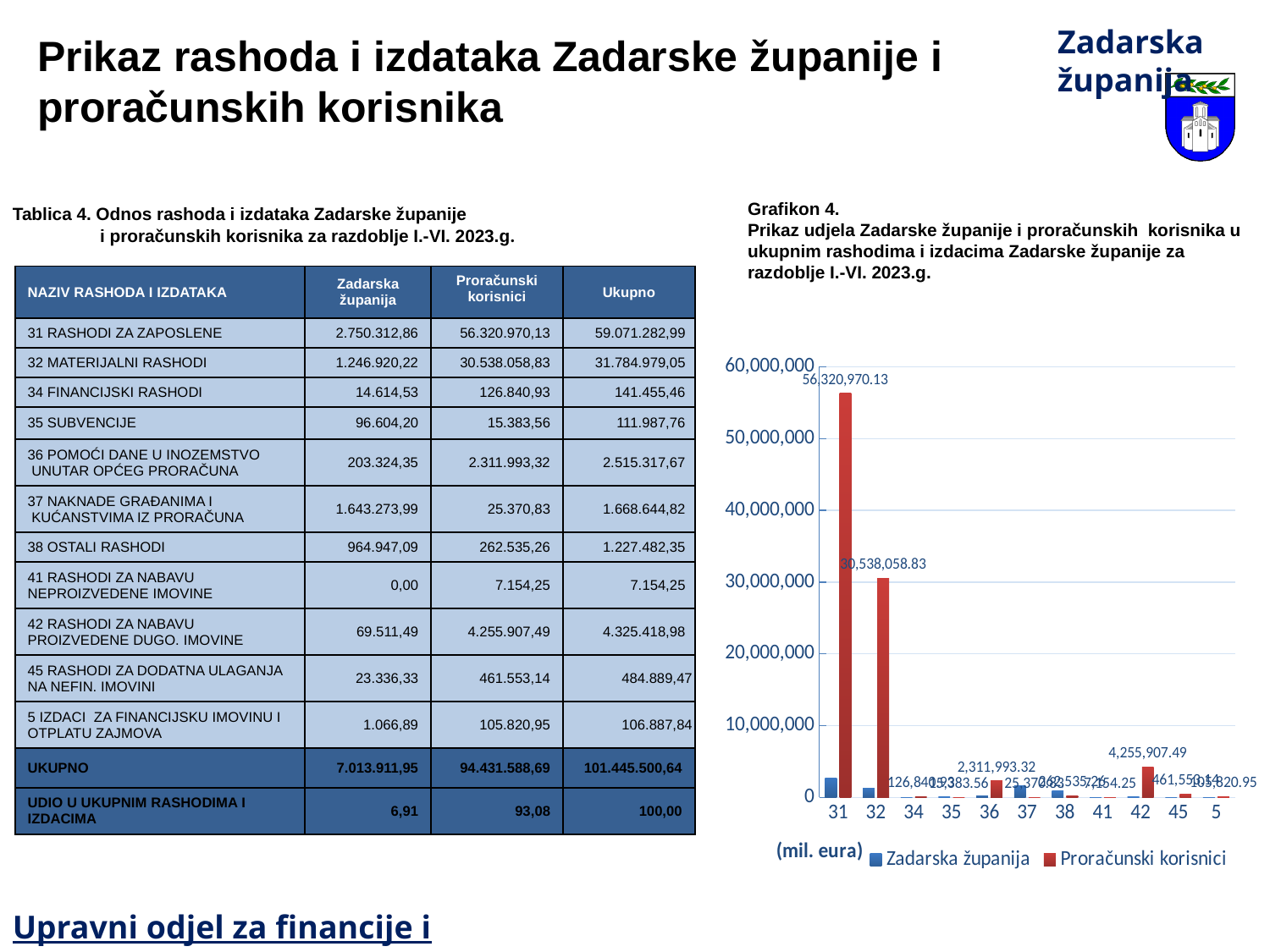
How many categories are shown along the x axis of the chart? 11 What is the value for Proračunski korisnici in category 42? 4,255,907.49 Which category has the highest value for Proračunski korisnici? 31 What is the value for Proračunski korisnici in category 36? 2,311,993.32 How many series does the chart legend list? 2 Which is larger for Proračunski korisnici: category 31 or category 32? 31 What kind of chart is shown on the slide? bar chart What are the two entries in the chart legend? Zadarska županija, Proračunski korisnici Is the value for Zadarska županija in category 31 greater or less than 10,000,000? less What is the difference between the Proračunski korisnici values for categories 31 and 32? 25,782,911.30 What is the value for Proračunski korisnici in category 31? 56,320,970.13 What is the value for Proračunski korisnici in category 32? 30,538,058.83